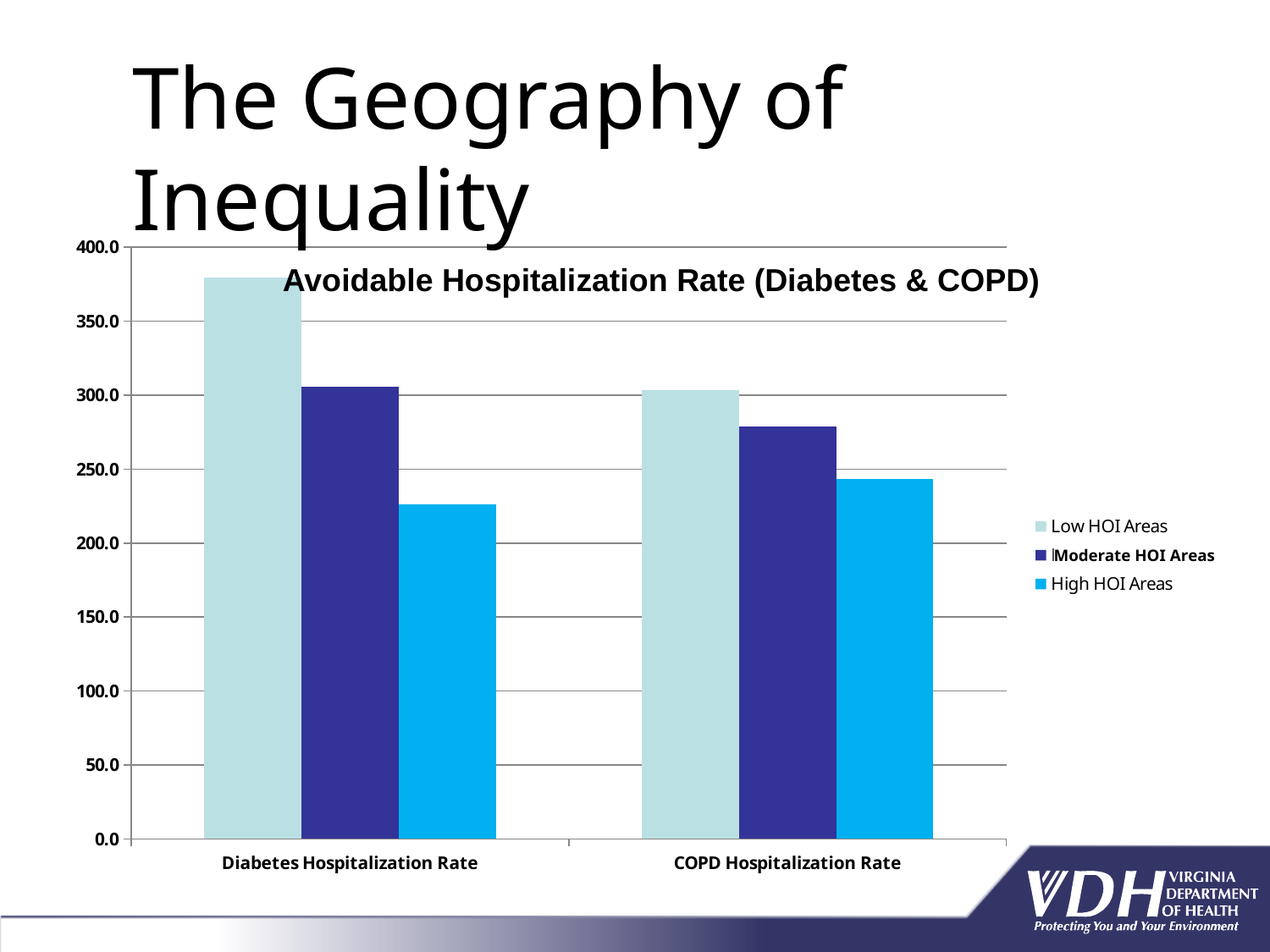
Which is larger: the COPD Hospitalization Rate for High HOI Areas or the Diabetes Hospitalization Rate for High HOI Areas? COPD Hospitalization Rate for High HOI Areas Is the Diabetes Hospitalization Rate for Moderate HOI Areas greater or less than 250.0? greater What is the title of the chart? Avoidable Hospitalization Rate (Diabetes & COPD) Which series has the highest Diabetes Hospitalization Rate? Low HOI Areas Which is larger: the Diabetes Hospitalization Rate for Low HOI Areas or the COPD Hospitalization Rate for Low HOI Areas? Diabetes Hospitalization Rate for Low HOI Areas How many series does the legend list? 3 Which series has the lowest COPD Hospitalization Rate? High HOI Areas How many categories are shown on the x axis? 2 What kind of chart is shown on the slide? bar chart Is the COPD Hospitalization Rate for Moderate HOI Areas greater or less than 300.0? less Is the Diabetes Hospitalization Rate for Low HOI Areas greater or less than 350.0? greater